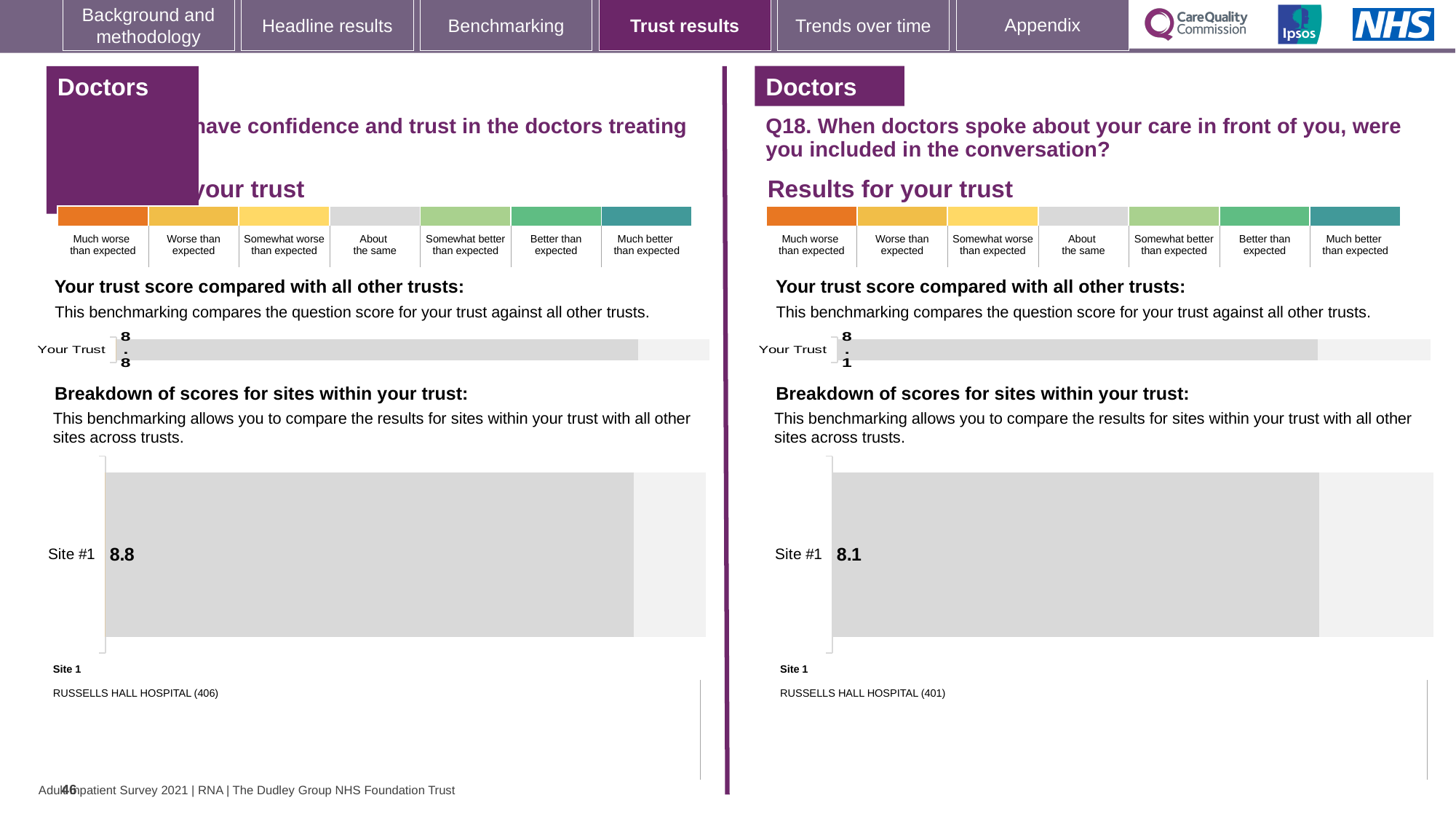
How many sites are plotted in the left 'Breakdown of scores for sites within your trust' chart? 1 What type of chart is used to show the Your Trust score on the right half of the slide (Q18)? Bar chart On the right half of the slide (Q18), what is the value shown for Your Trust in the 'Your trust score compared with all other trusts' chart? 8.1 Which is larger: the Your Trust score on the left half of the slide or the Your Trust score on the right half (Q18)? Left half (8.8) What type of chart is used in the left 'Breakdown of scores for sites within your trust' section? Bar chart Which hospital is listed as Site 1 below the right breakdown chart (Q18)? RUSSELLS HALL HOSPITAL (401) On the left half of the slide, what is the value shown for Your Trust in the 'Your trust score compared with all other trusts' chart? 8.8 In the left 'Breakdown of scores for sites within your trust' chart, what is the value for Site #1? 8.8 What is the difference between the Site #1 score in the left breakdown chart and the Site #1 score in the right breakdown chart (Q18)? 0.7 In the right 'Breakdown of scores for sites within your trust' chart (Q18), what is the value for Site #1? 8.1 Which hospital is listed as Site 1 below the left breakdown chart? RUSSELLS HALL HOSPITAL (406) How many sites are plotted in the right 'Breakdown of scores for sites within your trust' chart (Q18)? 1